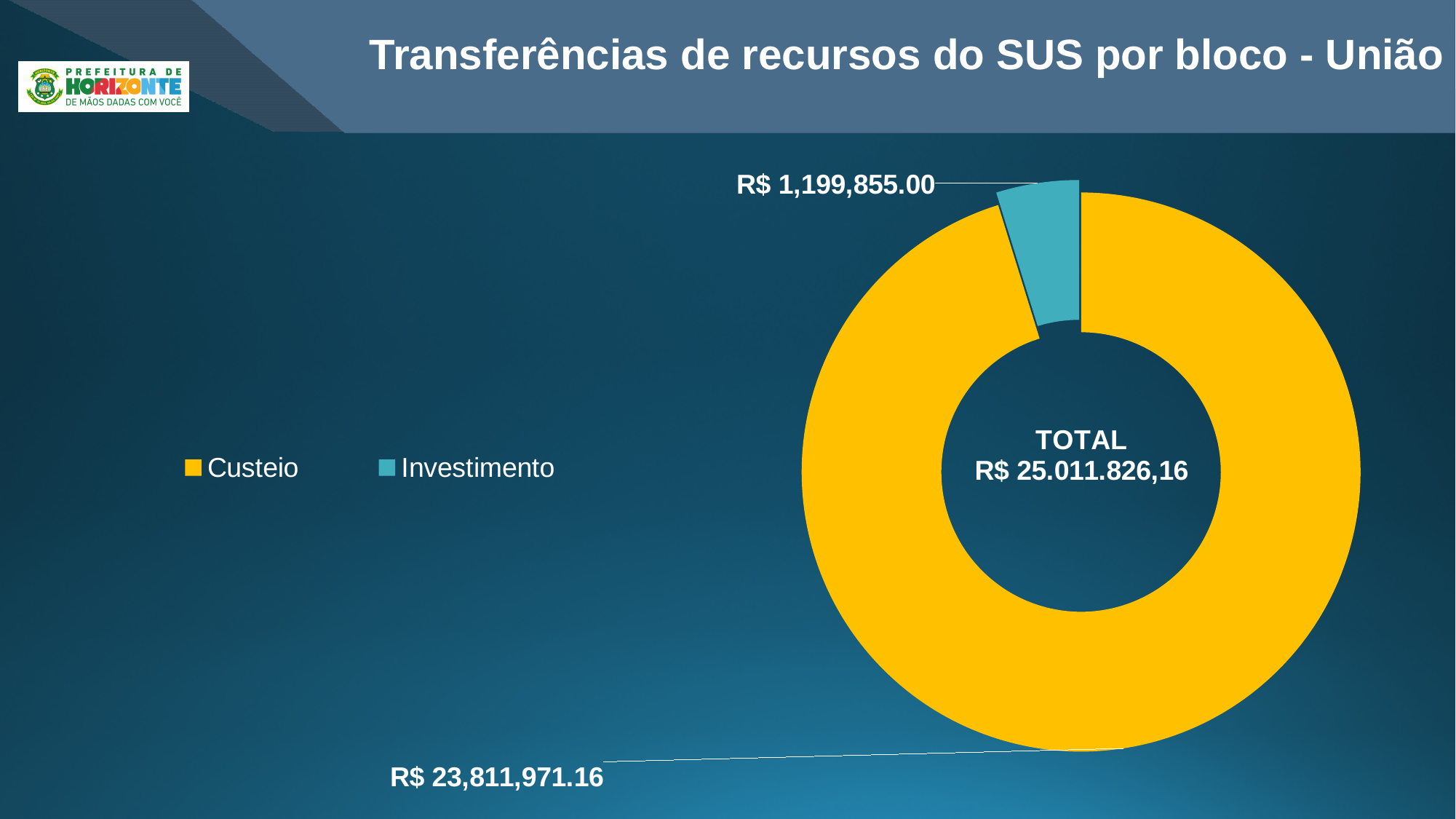
What is the difference between the Custeio and Investimento values? R$ 22,612,116.16 What colour represents Investimento in the chart? teal Which category has the largest slice? Custeio What is the value for Investimento? R$ 1,199,855.00 Which is larger, Custeio or Investimento? Custeio How many categories does the chart show? 2 What kind of chart is shown on the slide? doughnut chart What total is shown in the centre of the chart? R$ 25.011.826,16 Which category has the smallest slice? Investimento How many entries does the legend list? 2 What is the value for Custeio? R$ 23,811,971.16 What is the title of the chart? Transferências de recursos do SUS por bloco - União